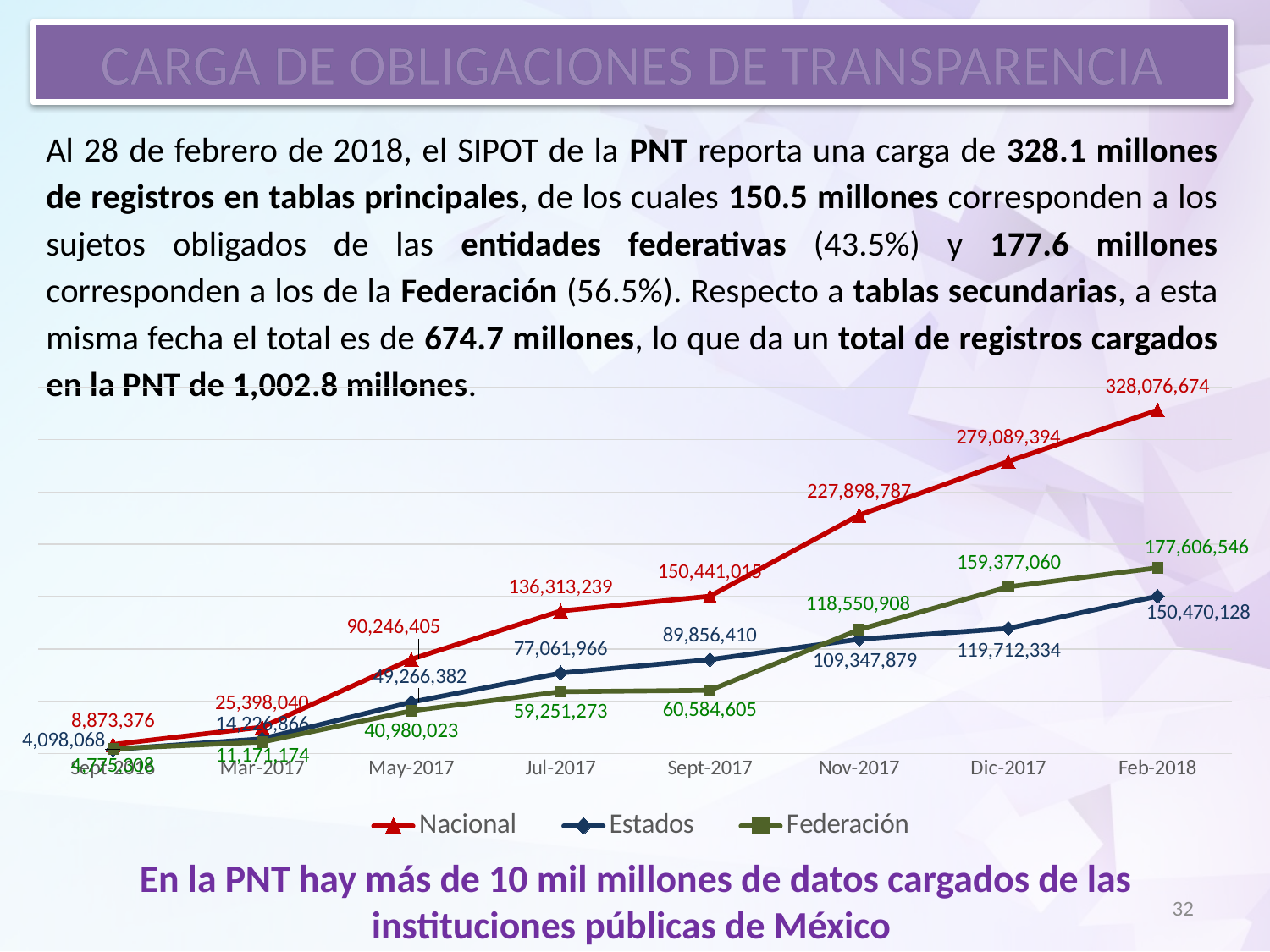
What is the value of the Nacional series at Feb-2018? 328,076,674 What is the value of the Federación series at Dic-2017? 159,377,060 What kind of chart is shown on the slide? Line chart What is the value of the Nacional series at May-2017? 90,246,405 At Nov-2017, which series has the larger value: Estados or Federación? Federación How many dates are shown on the x axis? 8 Does the Nacional series rise or fall from Sept-2016 to Feb-2018? Rise At which date is the Estados series at its lowest value? Sept-2016 What is the value of the Estados series at Jul-2017? 77,061,966 How many series does the legend list? 3 What is the difference between the Nacional value and the Estados value at Feb-2018? 177,606,546 At which date does the Nacional series reach its highest value? Feb-2018